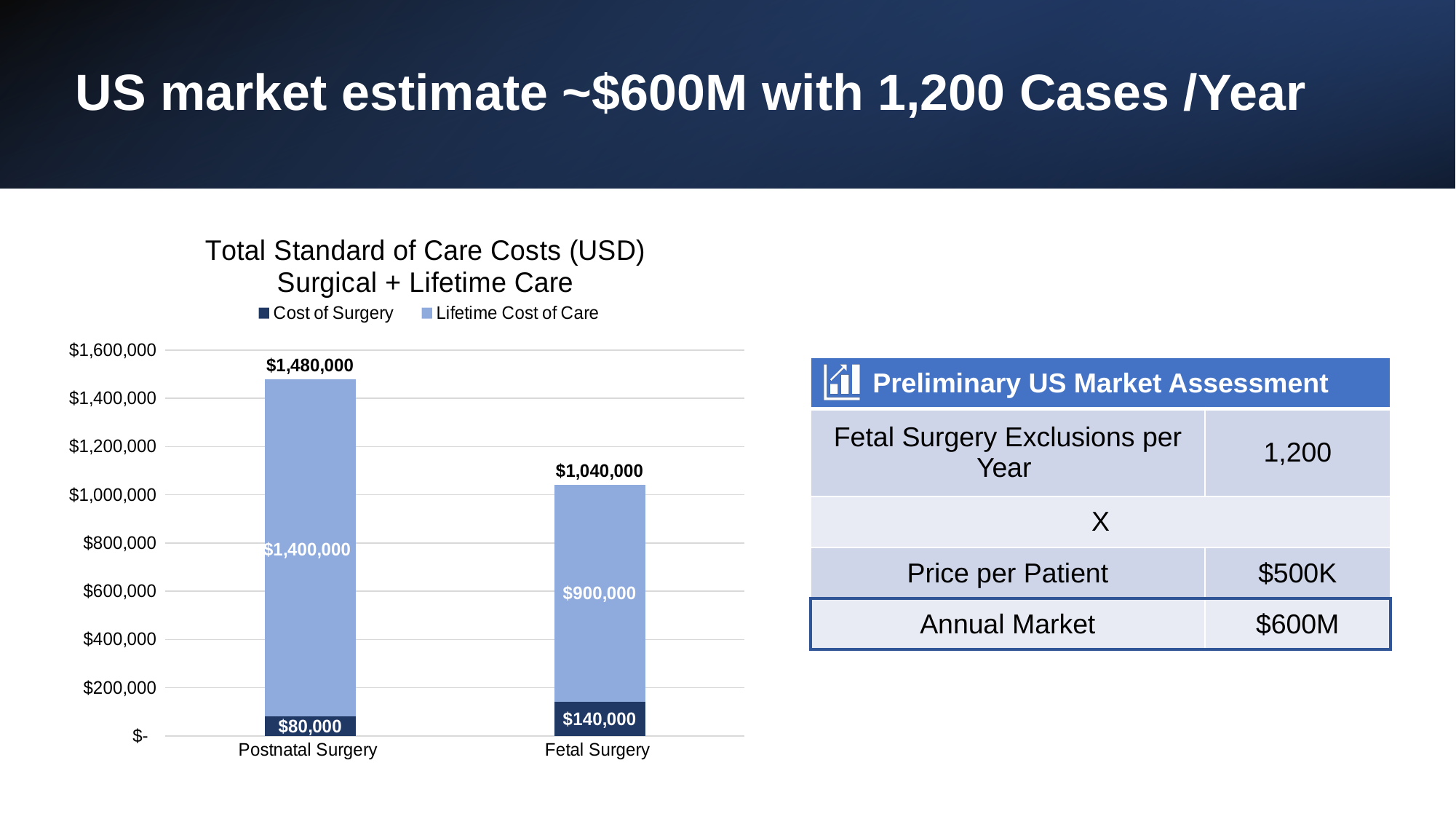
What is the difference in Cost of Surgery between Fetal Surgery and Postnatal Surgery? $60,000 How many categories are shown on the x axis of the chart? 2 How many series does the chart legend list? 2 What is the total of the stacked bar for Fetal Surgery? $1,040,000 What is the total of the stacked bar for Postnatal Surgery? $1,480,000 What is the Lifetime Cost of Care for Postnatal Surgery? $1,400,000 Which category has the higher total cost, Postnatal Surgery or Fetal Surgery? Postnatal Surgery What kind of chart is shown on the slide? Stacked bar chart What is the Lifetime Cost of Care for Fetal Surgery? $900,000 What is the Cost of Surgery for Postnatal Surgery? $80,000 What is the difference between the Lifetime Cost of Care for Postnatal Surgery and for Fetal Surgery? $500,000 What is the Cost of Surgery for Fetal Surgery? $140,000